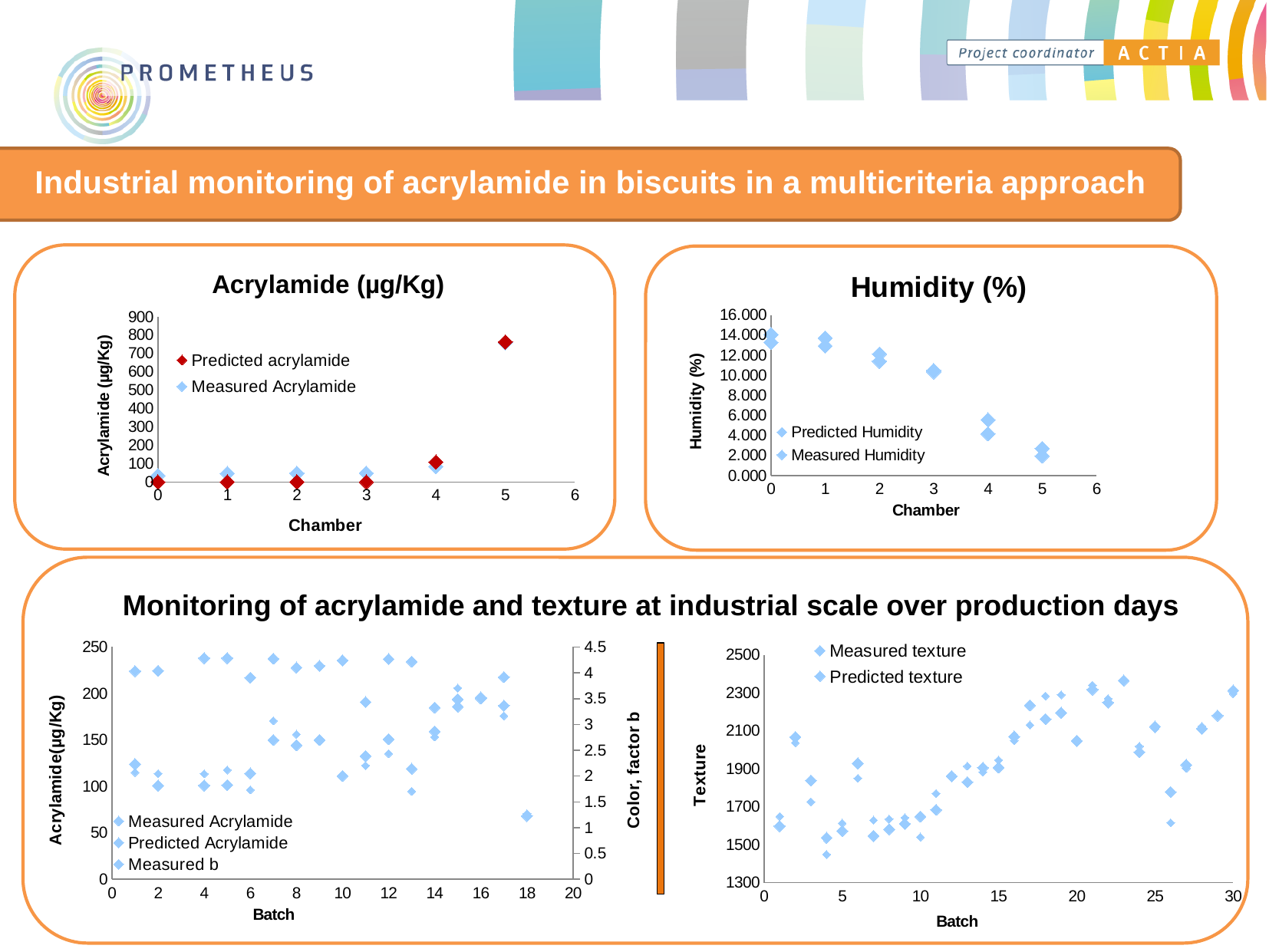
In the Acrylamide (µg/Kg) chart, at which chamber is the predicted acrylamide highest? Chamber 5 How many series does the legend of the Humidity (%) chart list? 2 In the Humidity (%) chart, at which chamber is the humidity lowest? Chamber 5 How many series does the legend of the Acrylamide (µg/Kg) chart list? 2 What kind of chart is the Acrylamide (µg/Kg) chart? Scatter chart In the bottom-right Texture chart, are the texture values at batch 4 greater or less than 1700? less How many series does the legend of the bottom-left chart (Acrylamide vs Batch with Color, factor b) list? 3 In the Humidity (%) chart, do the humidity values rise or fall as the chamber number increases? fall What is the label of the right-hand (secondary) y-axis on the bottom-left chart? Color, factor b In the Humidity (%) chart, is the humidity at chamber 3 greater or less than 8.000? greater In the Acrylamide (µg/Kg) chart, is the predicted acrylamide at chamber 5 greater or less than 500? greater What is the x-axis label of the Acrylamide (µg/Kg) chart? Chamber